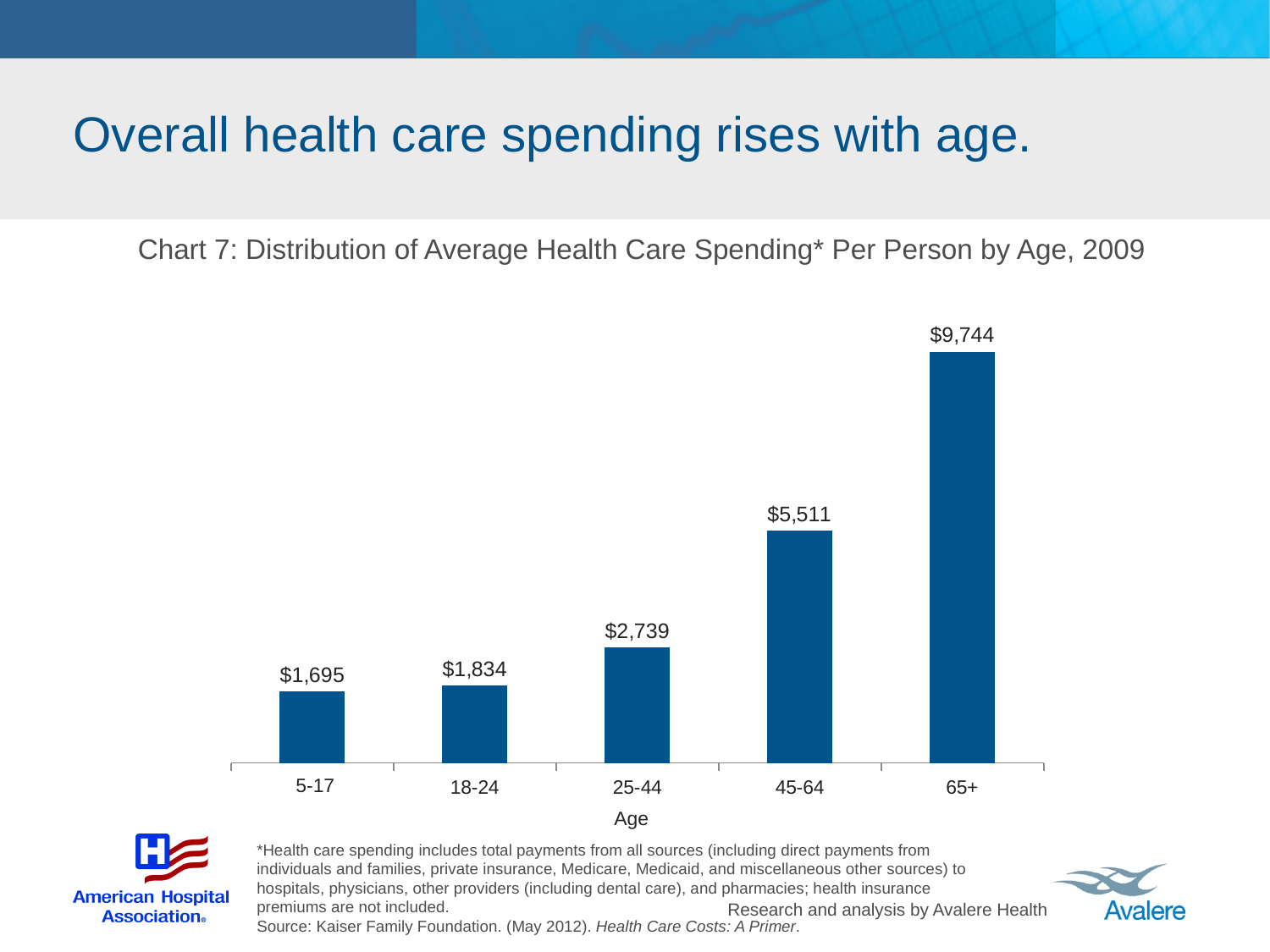
What is the label of the x axis? Age Do the values rise or fall as age increases along the x axis? Rise What is the difference in average spending between the 18-24 and 5-17 age groups? $139 Which age group has the highest average health care spending per person? 65+ What is the average health care spending per person for the 5-17 age group? $1,695 What is the average health care spending per person for the 65+ age group? $9,744 Which age group has the lowest average health care spending per person? 5-17 What is the difference in average spending between the 65+ and 45-64 age groups? $4,233 What is the average health care spending per person for the 25-44 age group? $2,739 What kind of chart is shown on the slide? Bar chart Which age group has higher average spending, 25-44 or 45-64? 45-64 How many age groups are shown in the chart? 5